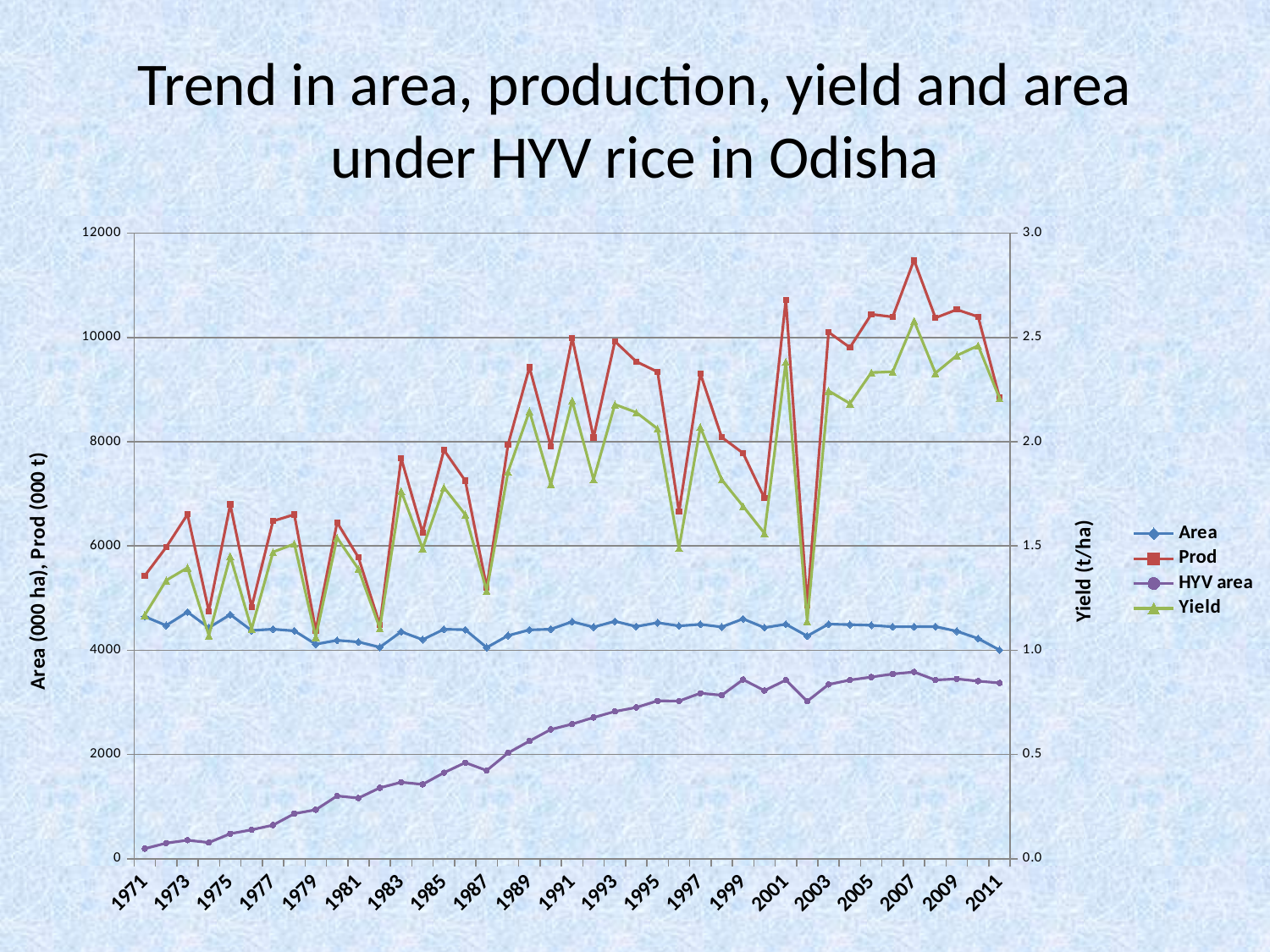
What kind of chart is shown on the slide? line chart In 2007, which is larger, Prod or Area? Prod Does the HYV area series generally rise or fall from 1971 to 2011? rise How many series does the legend list? 4 In which year is the HYV area series at its lowest? 1971 Is the Yield value for 2007 greater or less than 2.5? greater What is the label of the right-hand vertical axis? Yield (t/ha) In which year does the Prod series reach its highest value? 2007 Is the Prod value for 2007 greater or less than 10000? greater What are the four series named in the legend? Area, Prod, HYV area, Yield Is the HYV area value for 1971 greater or less than 2000? less